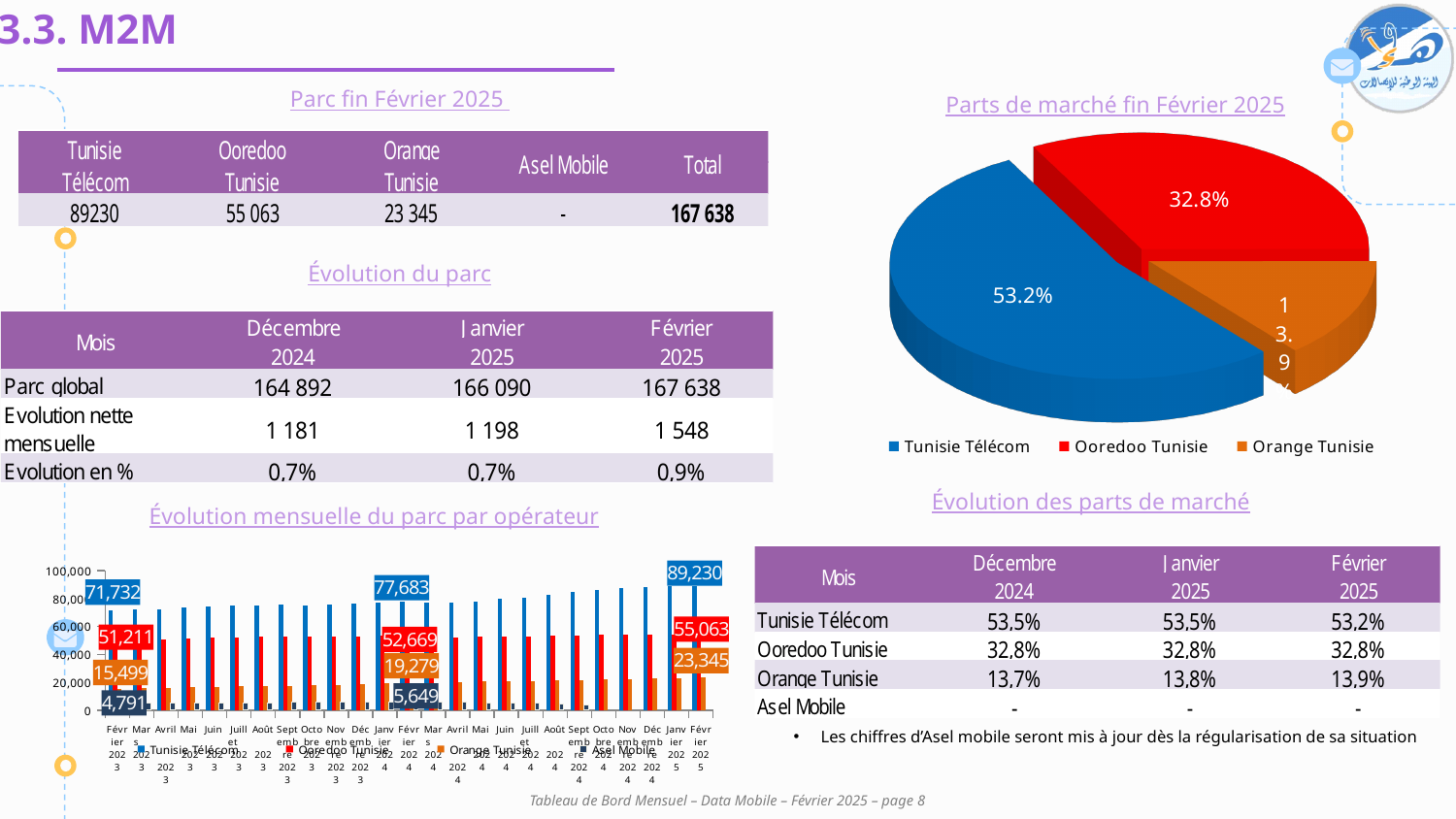
What kind of chart is 'Évolution mensuelle du parc par opérateur'? Bar chart In the pie chart 'Parts de marché fin Février 2025', which operator has the largest share? Tunisie Télécom In the pie chart 'Parts de marché fin Février 2025', what is the share for Tunisie Télécom? 53.2% What kind of chart is 'Parts de marché fin Février 2025'? Pie chart In the bar chart 'Évolution mensuelle du parc par opérateur', what is the value for Tunisie Télécom in Février 2025? 89,230 In the pie chart 'Parts de marché fin Février 2025', which operator has the smallest share? Orange Tunisie In the pie chart 'Parts de marché fin Février 2025', how many operators does the legend list? 3 In the pie chart 'Parts de marché fin Février 2025', what is the share for Ooredoo Tunisie? 32.8% In the bar chart 'Évolution mensuelle du parc par opérateur', how many series does the legend list? 4 In the bar chart 'Évolution mensuelle du parc par opérateur', what is the value for Orange Tunisie in Février 2025? 23,345